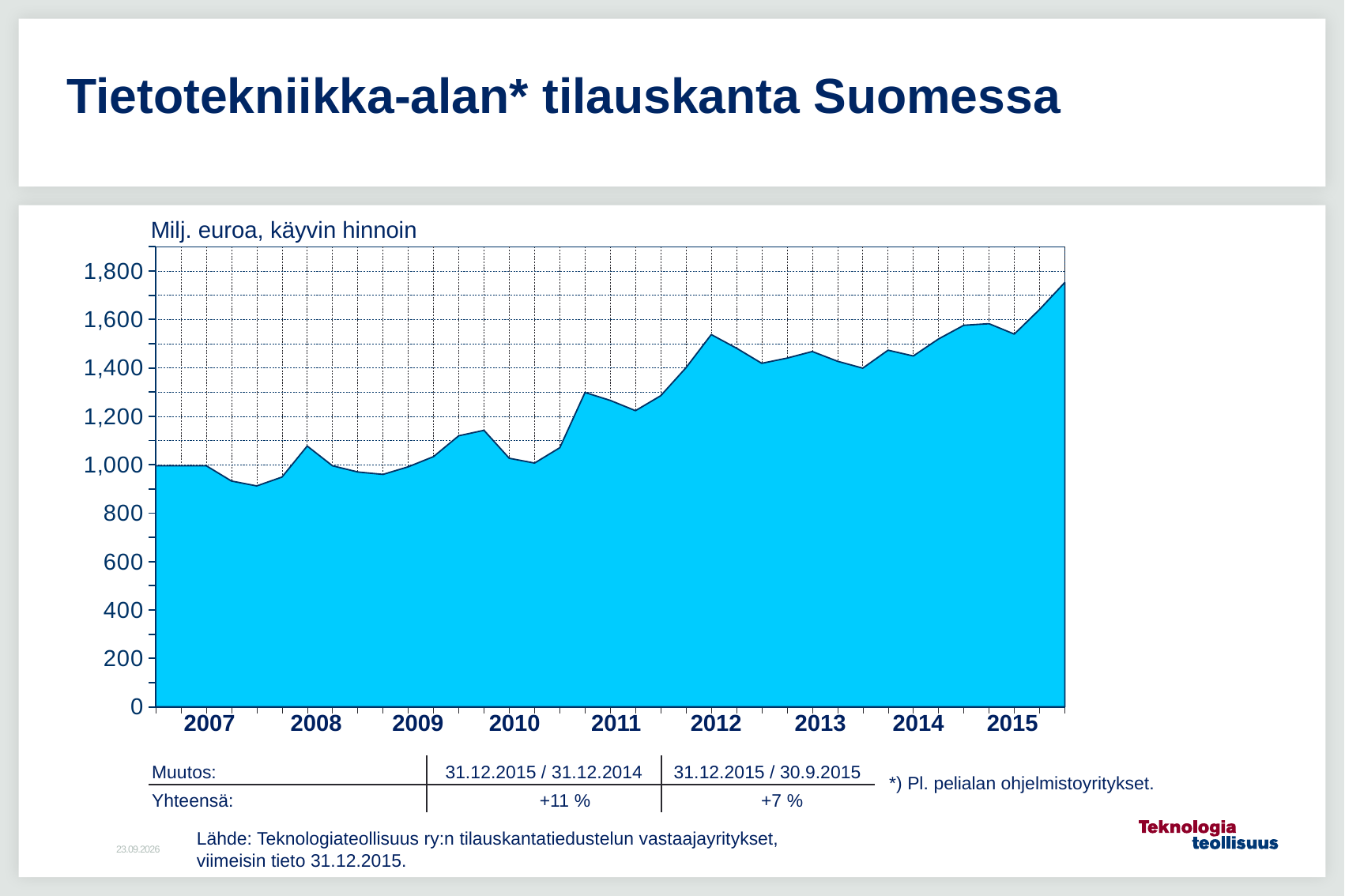
What kind of chart is shown on the slide? Area chart Is the peak value at the start of 2012 greater or less than 1,400? greater In which year does the series reach its lowest value? 2007 Overall, do the values rise or fall from 2007 to 2015? Rise Is the lowest value in 2007 greater or less than 1,000? less What unit label is shown above the chart? Milj. euroa, käyvin hinnoin Is the value at the end of 2015 greater or less than the value at the start of 2012? greater In which year does the series reach its highest value? 2015 Is the value at the end of 2015 greater or less than 1,600? greater What is the highest tick value shown on the y axis? 1,800 How many years are labelled on the x axis? 9